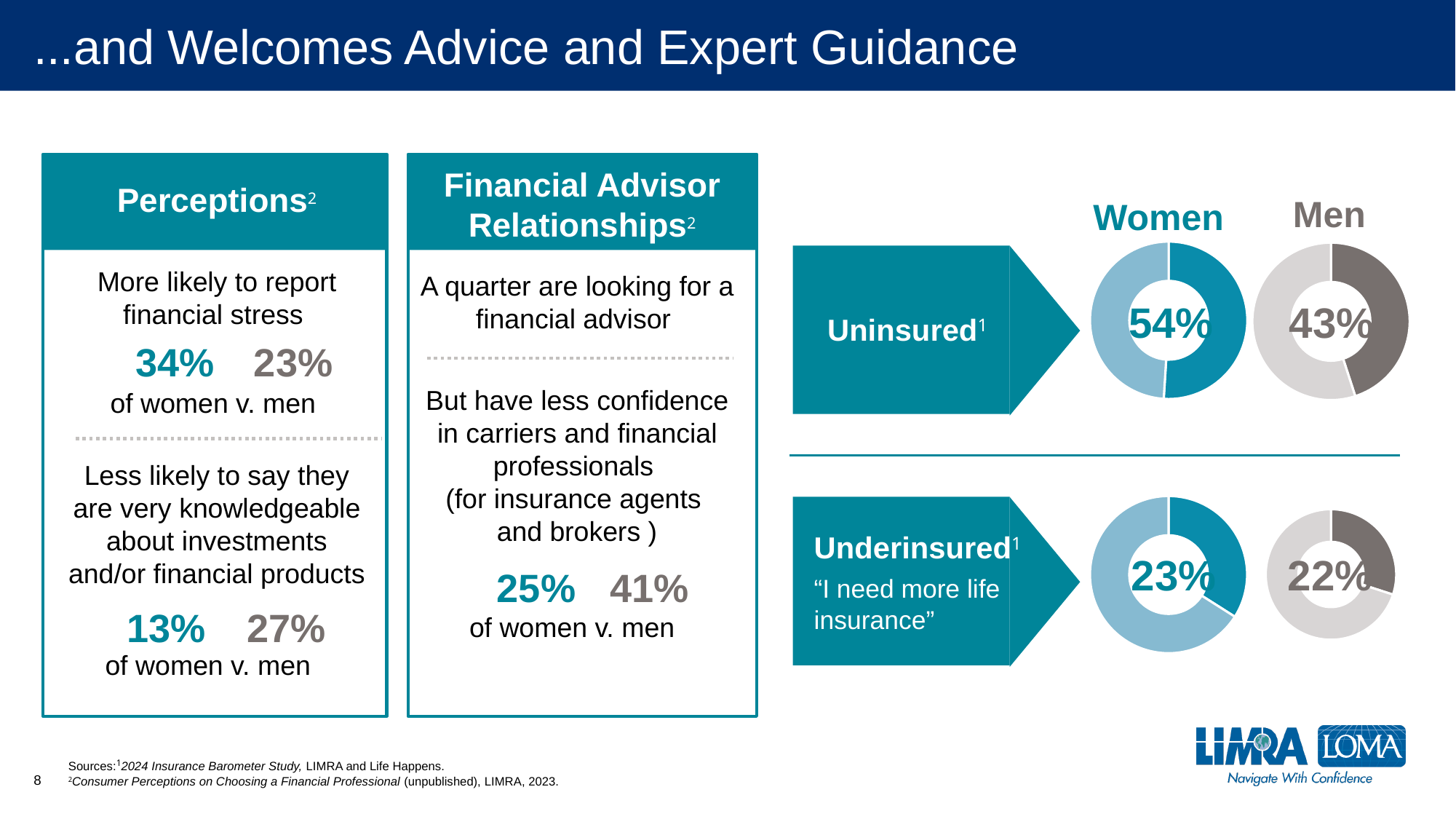
In the Underinsured row, what percentage is shown in the Men doughnut chart? 22% In the Underinsured row, what is the difference between the Women and Men percentages? 1 percentage point Which two groups are compared by the doughnut charts on the right side of the slide? Women and Men In the Uninsured row, what percentage is shown in the Men doughnut chart? 43% In the Underinsured row, what percentage is shown in the Women doughnut chart? 23% Across all four doughnut charts on the slide, which one shows the lowest percentage? Underinsured Men (22%) In the Uninsured row, what percentage is shown in the Women doughnut chart? 54% In the Uninsured row, which group has the larger percentage, Women or Men? Women What type of chart is used to show the Uninsured and Underinsured percentages on the right side of the slide? Doughnut chart Across all four doughnut charts on the slide, which one shows the highest percentage? Uninsured Women (54%) How many doughnut charts are shown on the slide? 4 In the Uninsured row, what is the difference between the Women and Men percentages? 11 percentage points